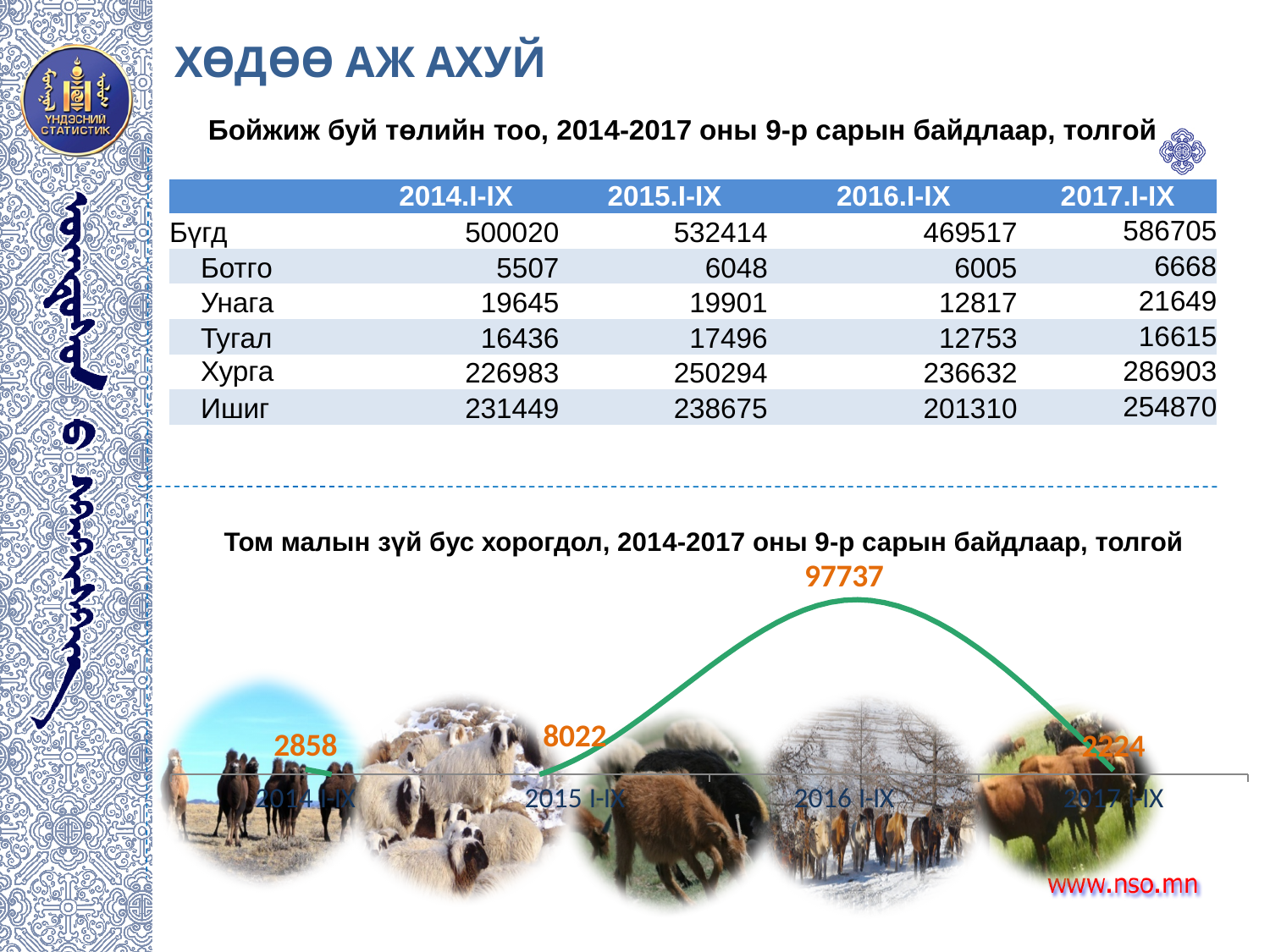
What kind of chart is shown at the bottom of the slide under the title 'Том малын зүй бус хорогдол'? line chart How many periods are plotted on the x axis of the line chart 'Том малын зүй бус хорогдол'? 4 What is the title of the line chart at the bottom of the slide? Том малын зүй бус хорогдол, 2014-2017 оны 9-р сарын байдлаар, толгой In the line chart 'Том малын зүй бус хорогдол', what is the value for 2016 I-IX? 97737 In the line chart 'Том малын зүй бус хорогдол', which period has the lowest value? 2017 I-IX In the line chart 'Том малын зүй бус хорогдол', which is larger, the value for 2015 I-IX or the value for 2014 I-IX? 2015 I-IX In the line chart 'Том малын зүй бус хорогдол', what is the difference between the values for 2015 I-IX and 2014 I-IX? 5164 In the line chart 'Том малын зүй бус хорогдол', what is the value for 2014 I-IX? 2858 In the line chart 'Том малын зүй бус хорогдол', what is the value for 2015 I-IX? 8022 In the line chart 'Том малын зүй бус хорогдол', which period has the highest value? 2016 I-IX In the line chart 'Том малын зүй бус хорогдол', does the value rise or fall from 2016 I-IX to 2017 I-IX? fall In the line chart 'Том малын зүй бус хорогдол', what is the difference between the values for 2016 I-IX and 2015 I-IX? 89715